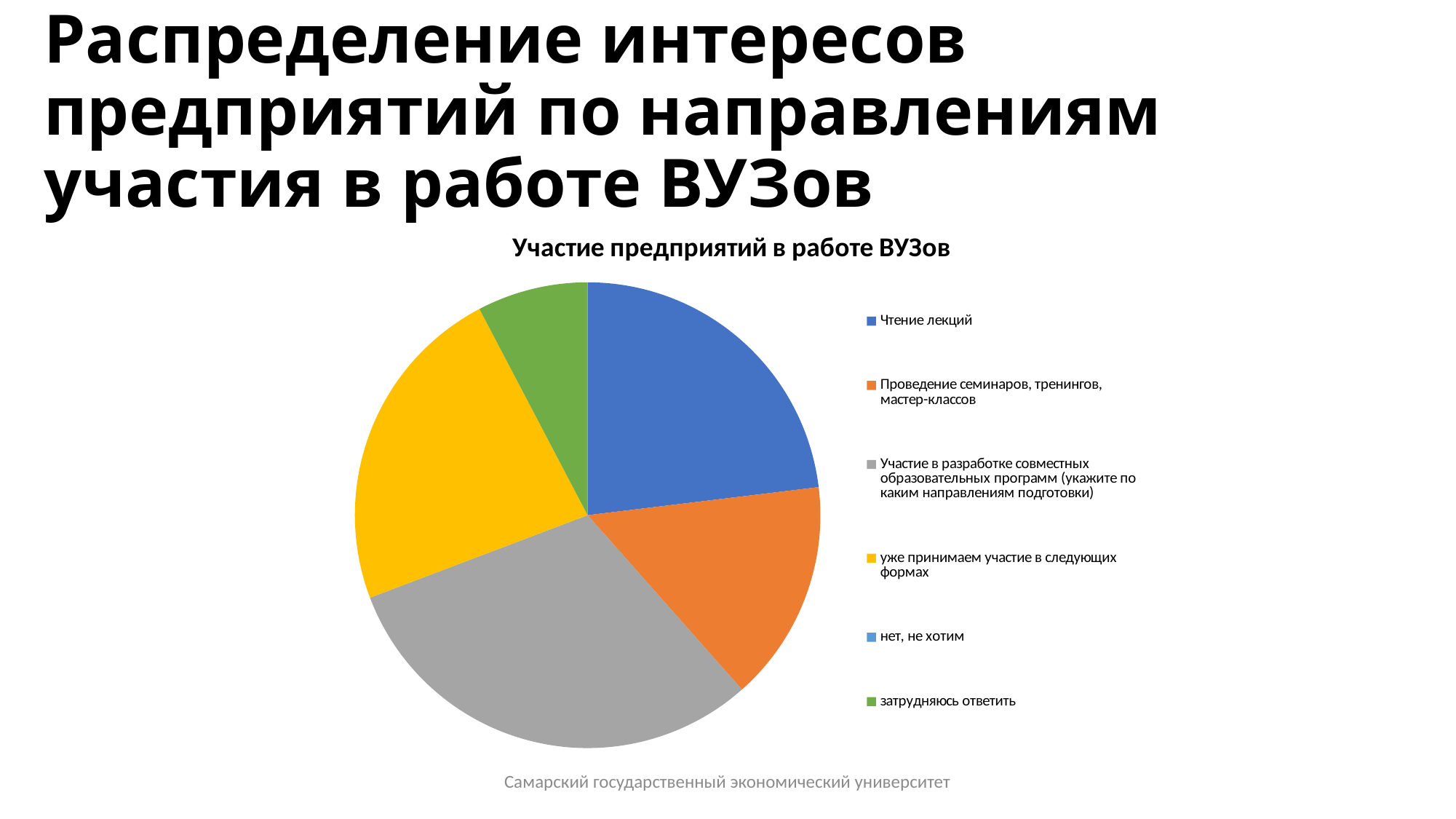
Which slice is larger: "Чтение лекций" or "затрудняюсь ответить"? Чтение лекций Which category has the largest slice of the pie? Участие в разработке совместных образовательных программ (укажите по каким направлениям подготовки) Which legend category is shown in yellow? уже принимаем участие в следующих формах Which slice is larger: "Проведение семинаров, тренингов, мастер-классов" or "Участие в разработке совместных образовательных программ"? Участие в разработке совместных образовательных программ Which category has the smallest visible slice of the pie? затрудняюсь ответить What kind of chart is shown on the slide? pie chart What is the title of the chart? Участие предприятий в работе ВУЗов What colour represents "Чтение лекций" in the chart? blue Which slice is larger: "уже принимаем участие в следующих формах" or "Проведение семинаров, тренингов, мастер-классов"? уже принимаем участие в следующих формах How many categories does the chart legend list? 6